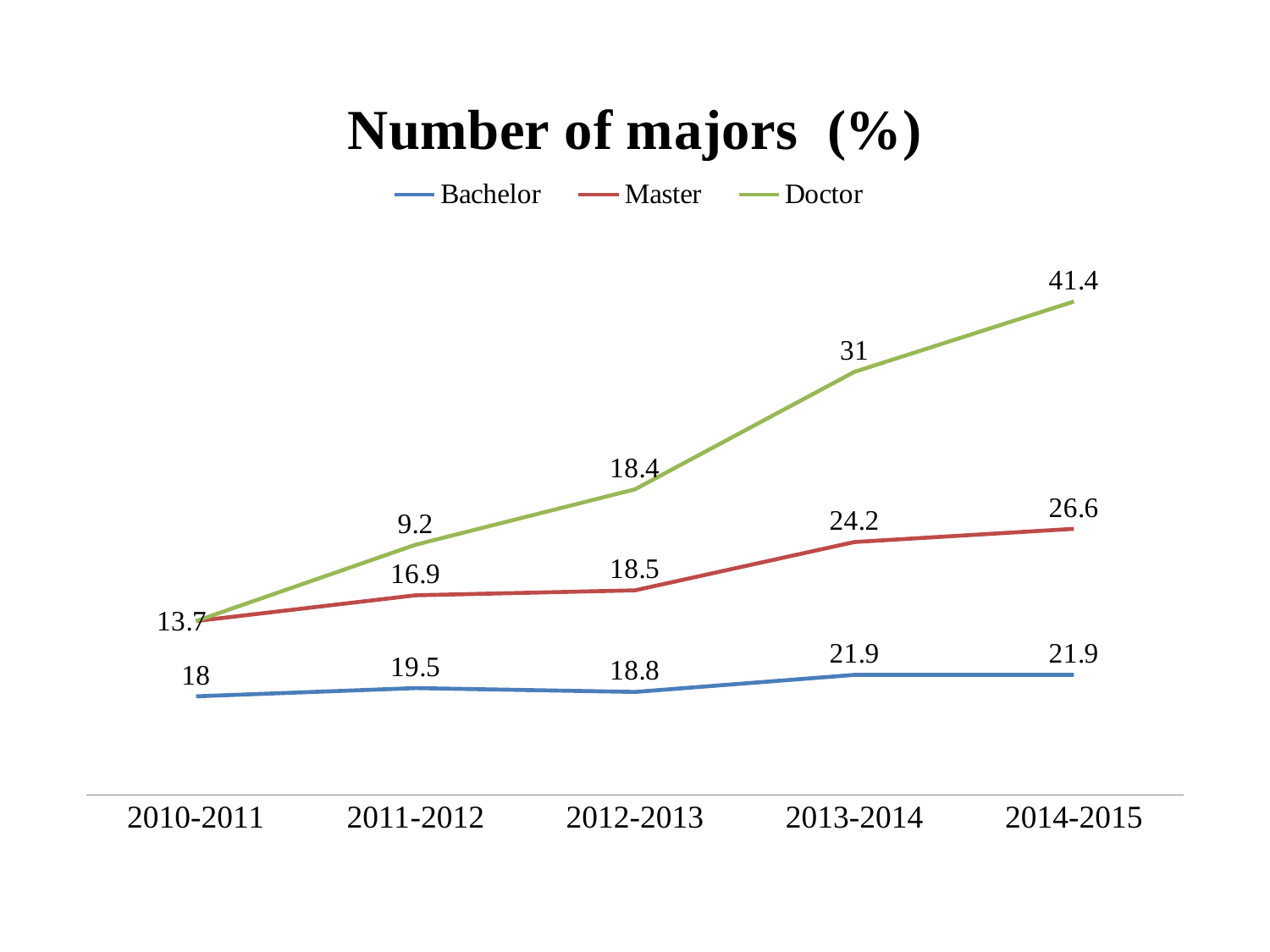
In which year is the Bachelor series lowest? 2010-2011 What kind of chart is shown on the slide? line chart How many series does the legend list? 3 What is the value for Doctor in 2014-2015? 41.4 In which year is the Doctor series highest? 2014-2015 What is the value for Bachelor in 2011-2012? 19.5 What is the value for Master in 2013-2014? 24.2 Which is larger for Bachelor: the value in 2011-2012 or in 2012-2013? 2011-2012 Does the Doctor series rise or fall from 2011-2012 to 2014-2015? rise What is the value for Doctor in 2013-2014? 31 How many academic years are shown on the x axis? 5 What is the difference between the Master values for 2014-2015 and 2013-2014? 2.4